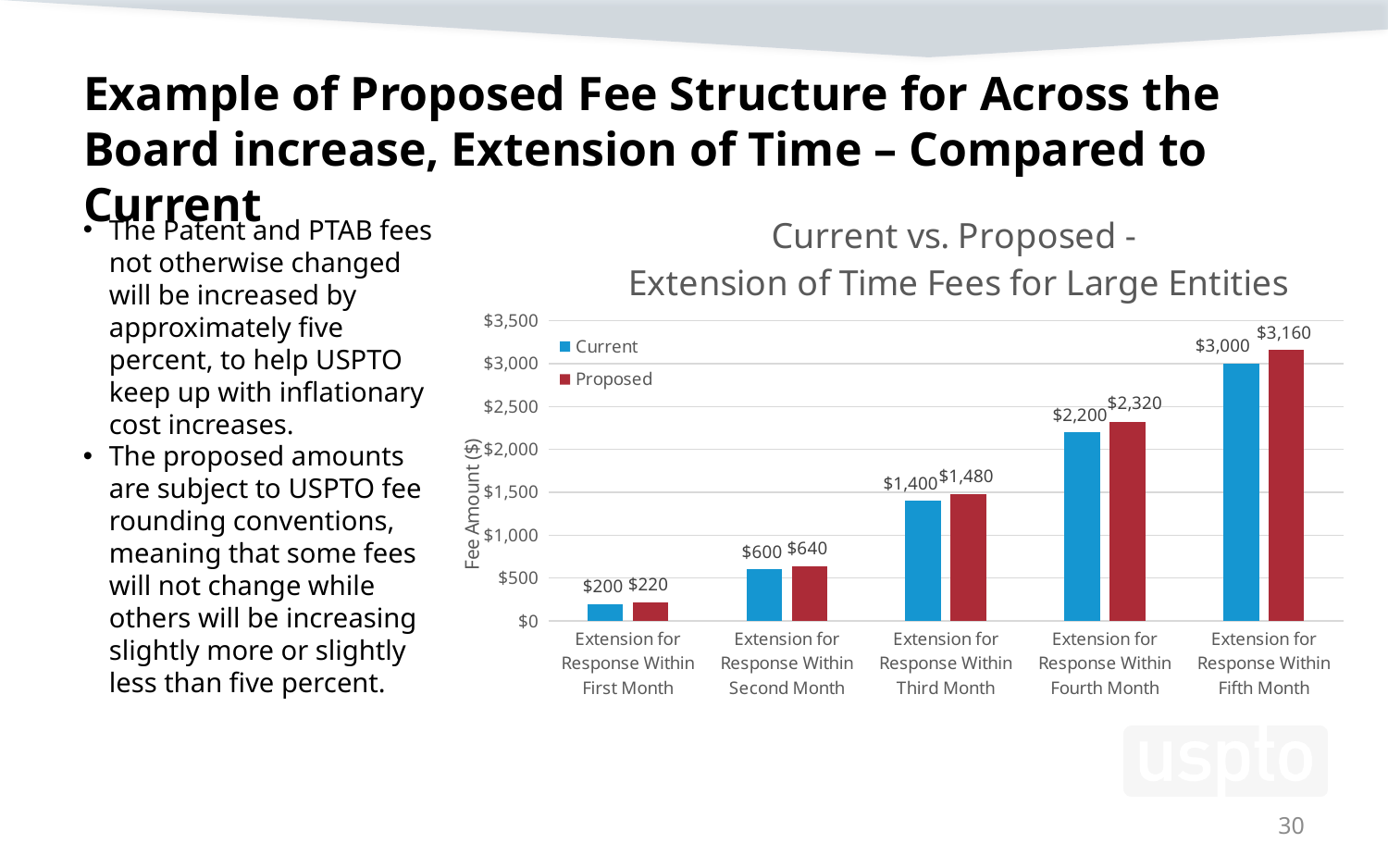
How many series does the legend list? 2 Which category has the lowest Current fee? Extension for Response Within First Month What is the difference between the Proposed and Current fees for Extension for Response Within Fourth Month? $120 What is the title of the chart? Current vs. Proposed - Extension of Time Fees for Large Entities Which is larger: the Proposed fee for Extension for Response Within Second Month or the Current fee for Extension for Response Within Third Month? Current fee for Extension for Response Within Third Month What is the Current fee for Extension for Response Within Third Month? $1,400 What is the Proposed fee for Extension for Response Within Fifth Month? $3,160 Do the Current fees rise or fall from First Month to Fifth Month? Rise What is the Proposed fee for Extension for Response Within First Month? $220 How many categories are shown on the x axis? 5 Which category has the highest Proposed fee? Extension for Response Within Fifth Month What kind of chart is shown on the slide? Bar chart